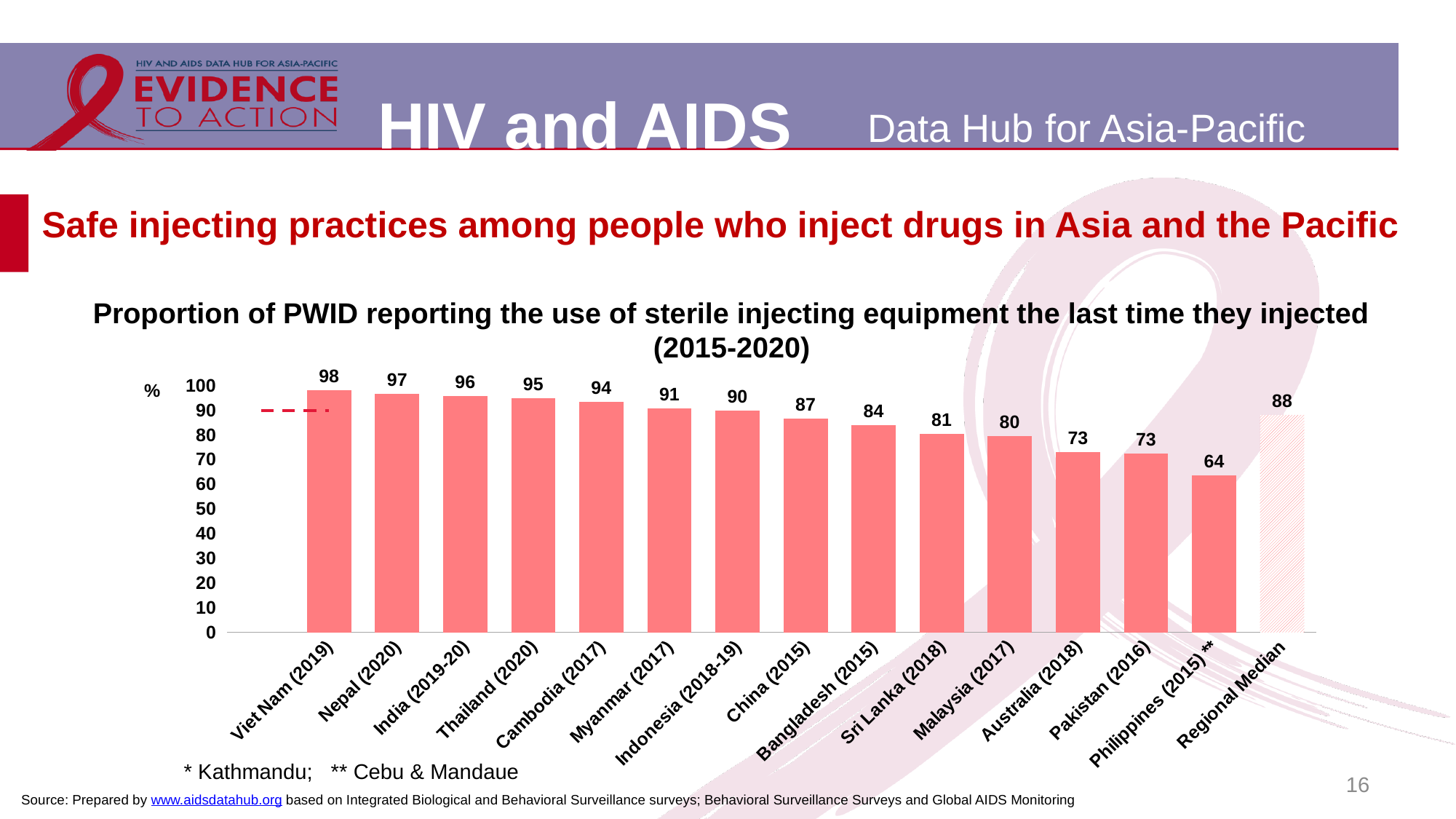
Is the value for Sri Lanka (2018) greater or less than 90? less What is the value for Viet Nam (2019)? 98 What is the difference between the values for Nepal (2020) and Malaysia (2017)? 17 Which country has the lowest value on the chart? Philippines (2015) ** What kind of chart is shown on the slide? Bar chart What is the value for Philippines (2015) **? 64 Do the country values rise or fall from left to right across the chart (excluding the Regional Median)? Fall How many bars are plotted on the chart, including the Regional Median? 15 Which country has the highest proportion of PWID reporting use of sterile injecting equipment? Viet Nam (2019) Which is larger, the value for China (2015) or the value for Bangladesh (2015)? China (2015) What is the value for Pakistan (2016)? 73 What is the Regional Median value shown on the chart? 88